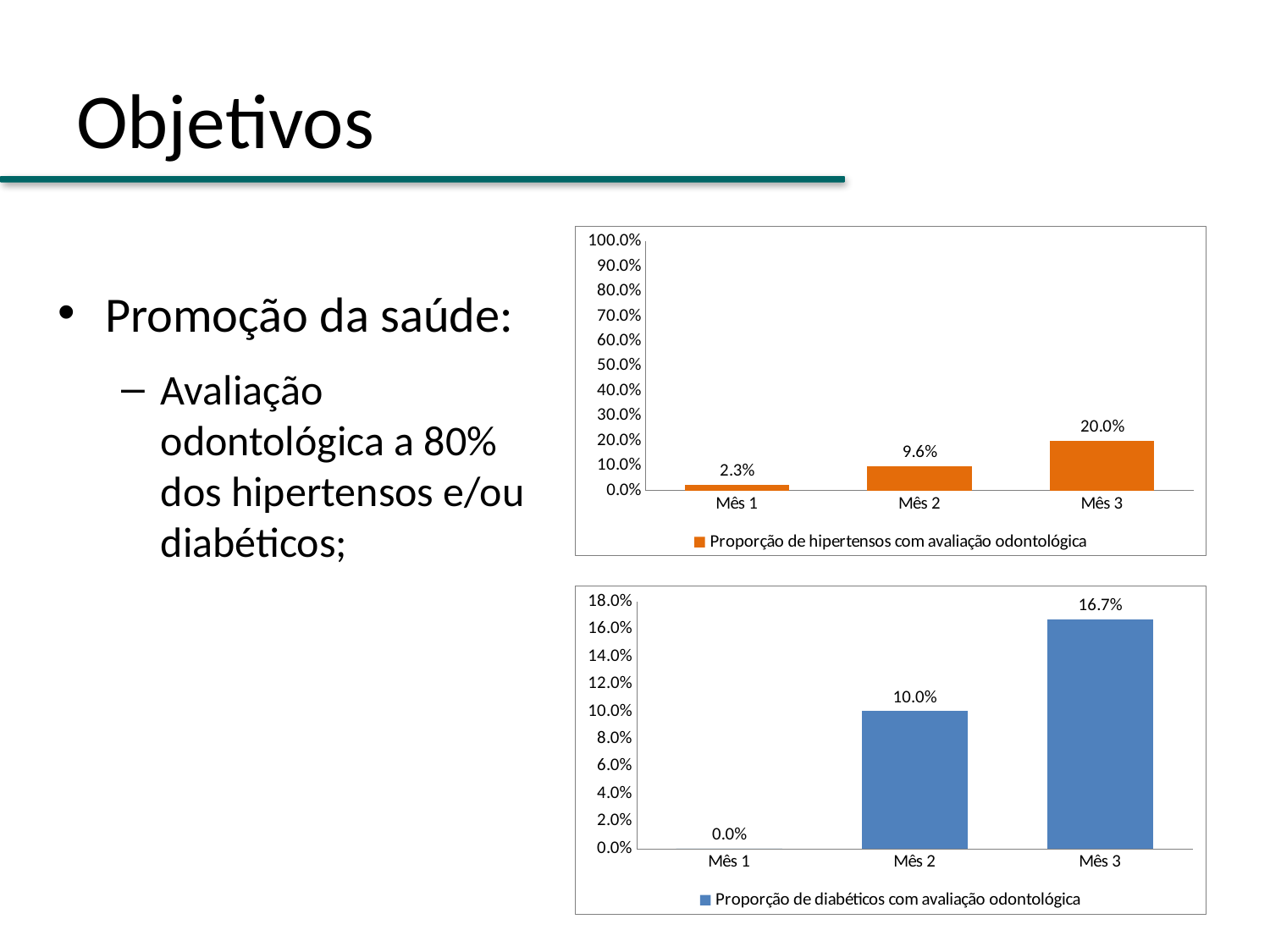
In the top chart (Proporção de hipertensos com avaliação odontológica), what is the value for Mês 3? 20.0% In the bottom chart (Proporção de diabéticos com avaliação odontológica), what is the difference between the values for Mês 3 and Mês 2? 6.7% What kind of chart is the bottom chart (Proporção de diabéticos com avaliação odontológica)? bar chart In the top chart (Proporção de hipertensos com avaliação odontológica), what is the value for Mês 2? 9.6% In the top chart (Proporção de hipertensos com avaliação odontológica), which month has the lowest value? Mês 1 In the bottom chart (Proporção de diabéticos com avaliação odontológica), what is the value for Mês 3? 16.7% In the bottom chart (Proporção de diabéticos com avaliação odontológica), do the values rise or fall from Mês 1 to Mês 3? rise In the bottom chart (Proporção de diabéticos com avaliação odontológica), what is the value for Mês 1? 0.0% In the top chart (Proporção de hipertensos com avaliação odontológica), what is the difference between the values for Mês 3 and Mês 1? 17.7% In the bottom chart (Proporção de diabéticos com avaliação odontológica), which month has the highest value? Mês 3 How many months are shown on the x axis of the top chart (Proporção de hipertensos com avaliação odontológica)? 3 In the top chart (Proporção de hipertensos com avaliação odontológica), which is larger: the value for Mês 2 or Mês 3? Mês 3